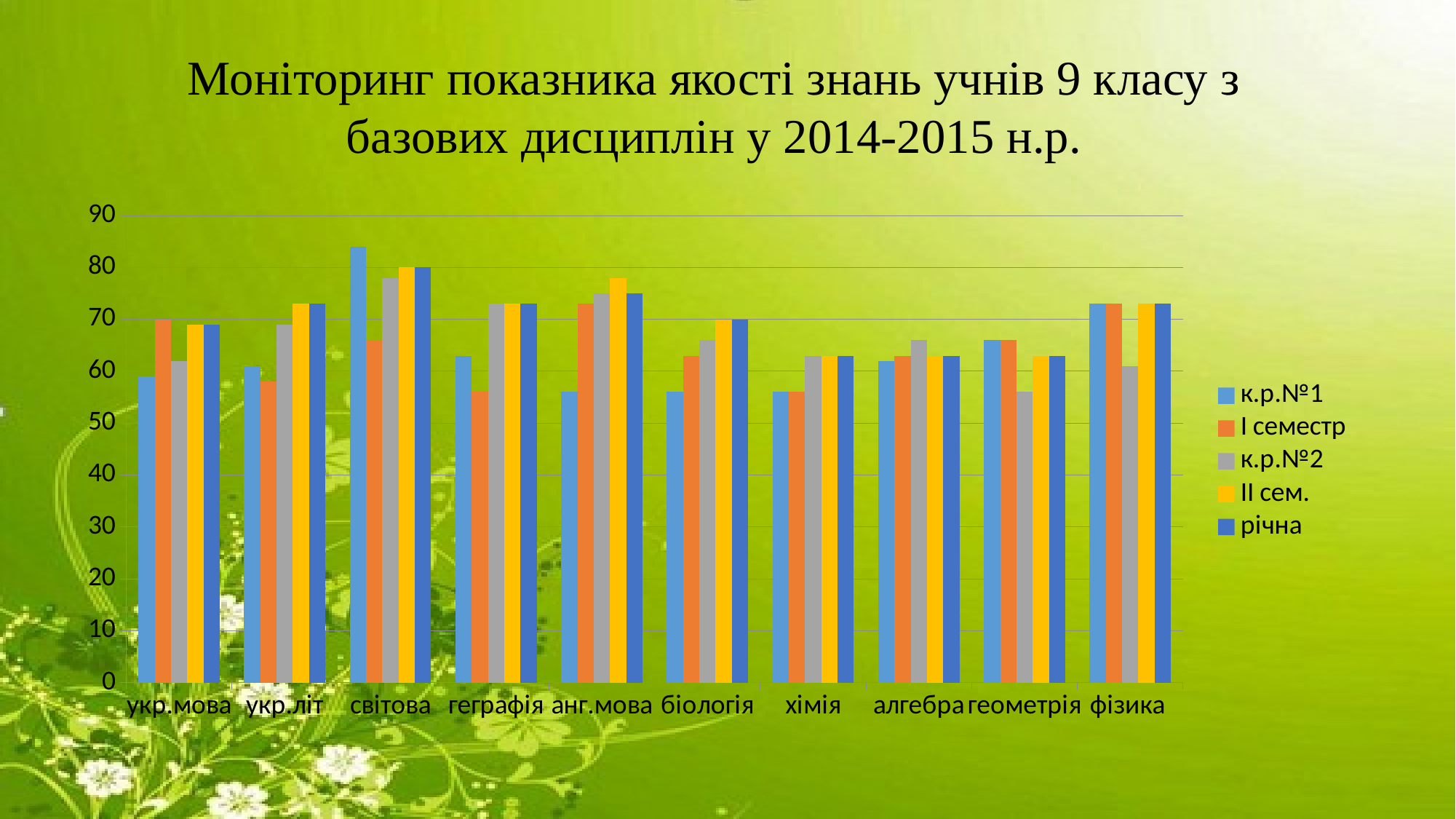
Is the І семестр value for геграфія greater or less than 60? less Is the к.р.№2 value for геометрія greater or less than 60? less Which is larger: the І семестр value for укр.мова or for укр.літ? укр.мова Which series is listed last in the legend? річна How many series does the legend list? 5 Which subject has the highest value for the к.р.№1 series? світова Which subject has the highest value for the річна series? світова How many subjects (categories) are shown on the x axis? 10 Is the к.р.№1 value for світова greater or less than 80? greater What kind of chart is shown on the slide? bar chart